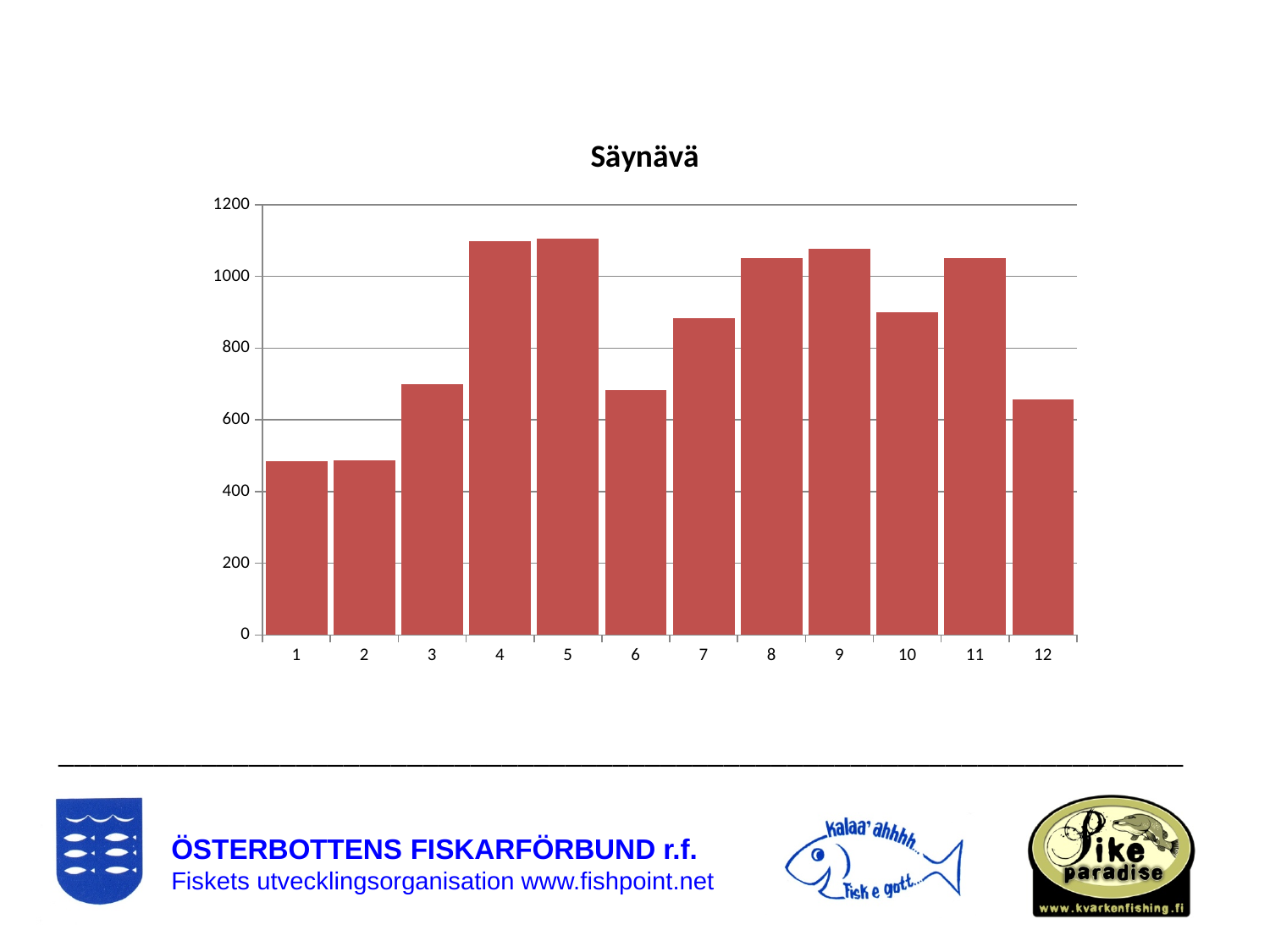
What is the title of the chart? Säynävä What kind of chart is shown on the slide? bar chart Is the value for category 7 greater or less than 800? greater Is the value for category 12 greater or less than 800? less Is the value for category 3 greater or less than 600? greater Which has the larger value, category 4 or category 6? category 4 Do the values rise or fall from category 1 to category 4? rise How many categories are shown on the x axis of the chart? 12 Which has the larger value, category 1 or category 3? category 3 Which has the larger value, category 10 or category 12? category 10